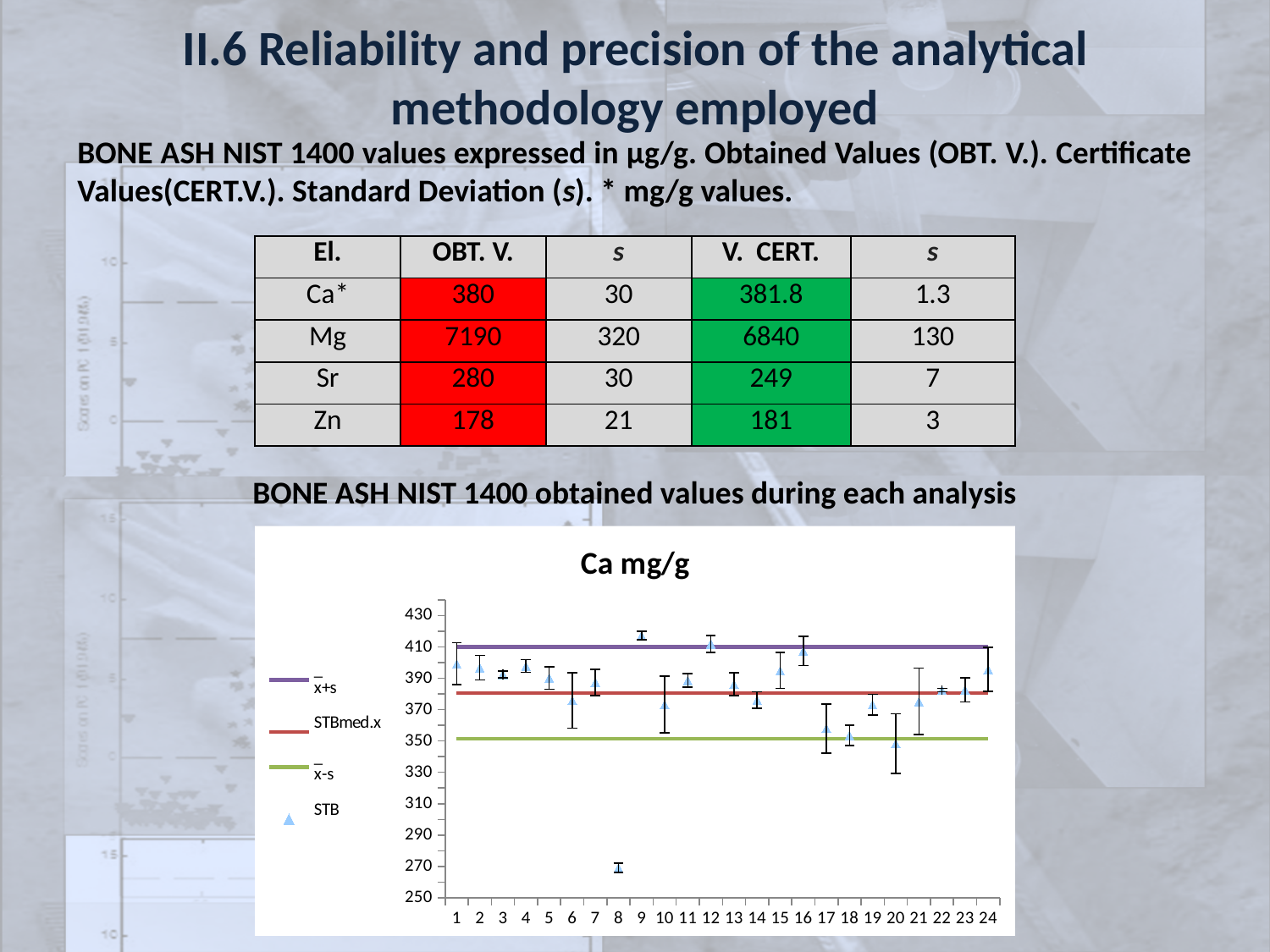
What is the title of the chart on the slide? Ca mg/g In the Ca mg/g chart, which has the larger STB value, analysis 1 or analysis 17? analysis 1 What colour is the x̄+s line in the Ca mg/g chart? purple In the Ca mg/g chart, which has the larger STB value, analysis 8 or analysis 9? analysis 9 Which analysis number has the lowest STB value in the Ca mg/g chart? 8 In the Ca mg/g chart, is the STB value for analysis 9 greater or less than 410? greater How many series does the legend of the Ca mg/g chart list? 4 How many analysis points are plotted along the x axis of the Ca mg/g chart? 24 In the Ca mg/g chart, is the STB value for analysis 16 greater or less than 390? greater In the Ca mg/g chart, is the STB value for analysis 8 greater or less than 290? less Which analysis number has the highest STB value in the Ca mg/g chart? 9